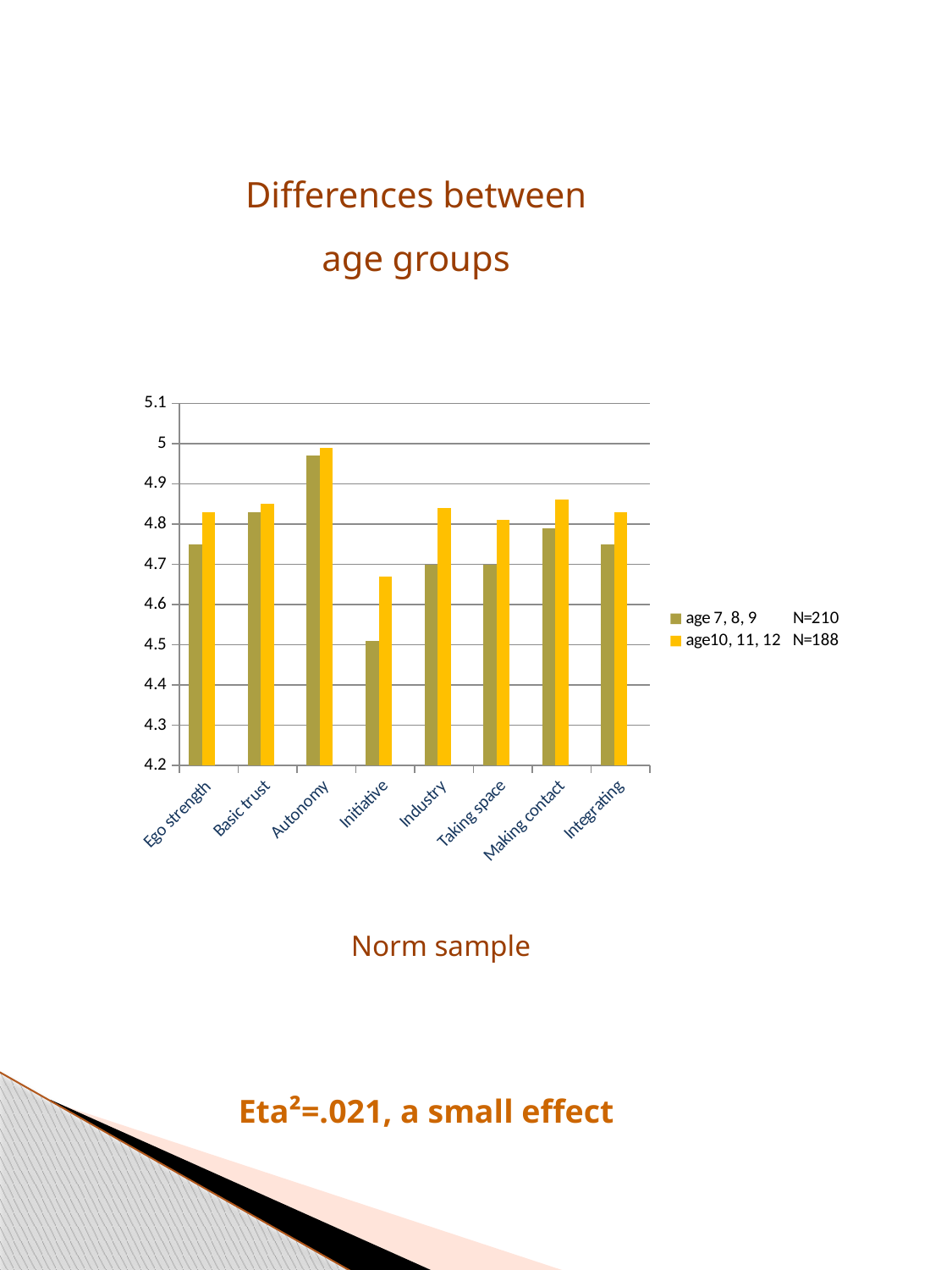
What sample size (N) does the legend give for the age10, 11, 12 series? N=188 Which category has the lowest value for the age10, 11, 12 series? Initiative Which category has the highest value for the age 7, 8, 9 series? Autonomy How many series does the chart's legend list? 2 Is the value for Initiative in the age 7, 8, 9 series greater or less than 4.6? less Is the value for Autonomy in the age 7, 8, 9 series greater or less than 4.9? greater For Initiative, which series has the larger value: age 7, 8, 9 or age10, 11, 12? age10, 11, 12 What is the title of the chart? Differences between age groups Which category has the highest value for the age10, 11, 12 series? Autonomy How many categories are shown on the x axis of the chart? 8 What kind of chart is shown on the slide? bar chart Which category has the lowest value for the age 7, 8, 9 series? Initiative